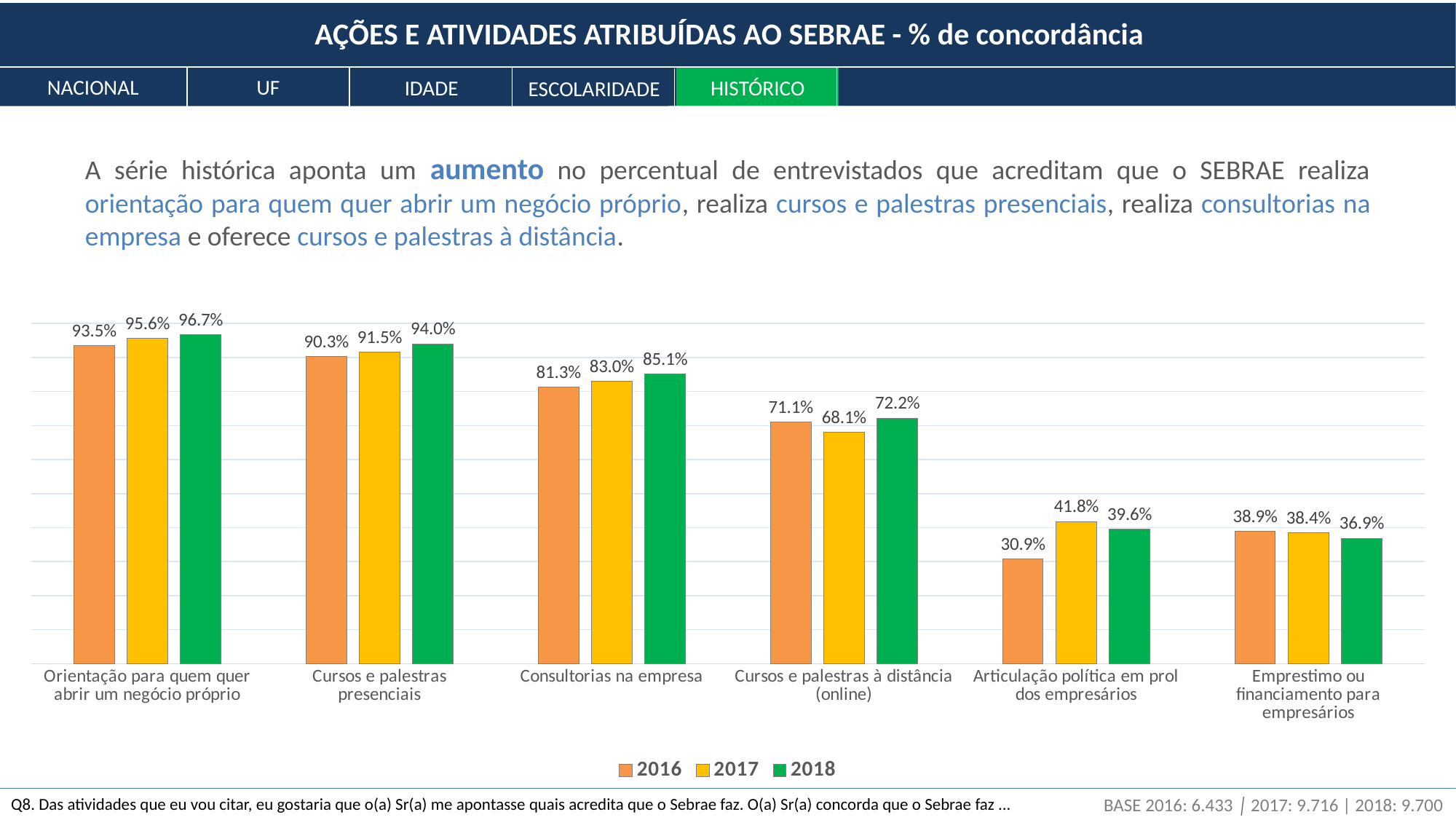
What is the 2016 value for "Articulação política em prol dos empresários"? 30.9% What is the 2018 value for "Orientação para quem quer abrir um negócio próprio"? 96.7% Do the 2018 values rise or fall from "Orientação para quem quer abrir um negócio próprio" to "Emprestimo ou financiamento para empresários"? Fall Which category has the lowest 2016 value? Articulação política em prol dos empresários What is the difference between the 2018 and 2016 values for "Consultorias na empresa"? 3.8% For "Emprestimo ou financiamento para empresários", which year has the larger value, 2016 or 2018? 2016 Which colour represents the 2017 series in the legend? Yellow Which category has the highest 2018 value? Orientação para quem quer abrir um negócio próprio How many categories are shown on the x axis? 6 What is the 2017 value for "Cursos e palestras à distância (online)"? 68.1% How many series does the legend list? 3 What kind of chart is shown on the slide? Bar chart